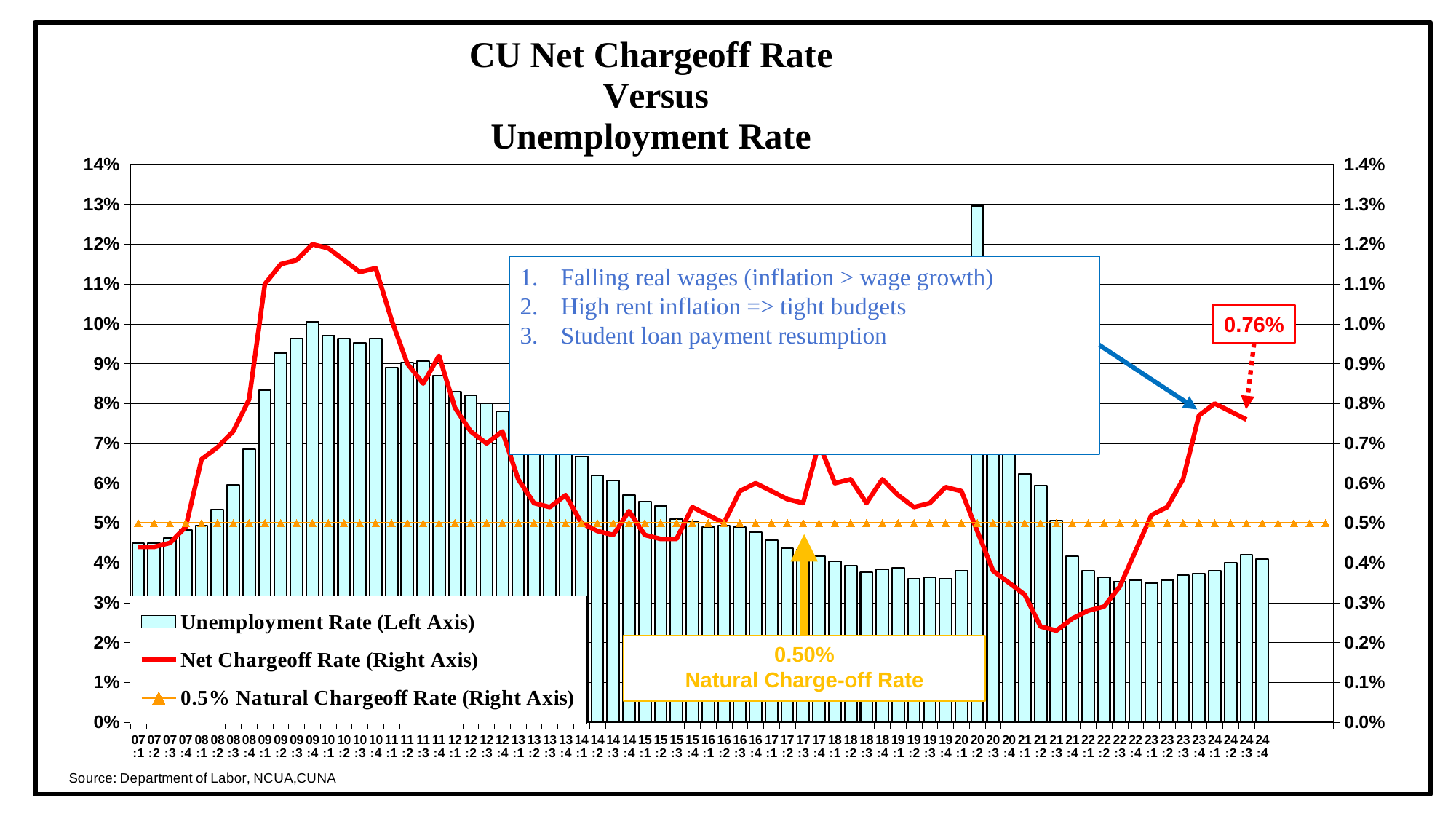
Does the Unemployment Rate rise or fall from 21:1 to 21:4? fall On which axis is the Unemployment Rate plotted? Left Axis What is the title of the chart? CU Net Chargeoff Rate Versus Unemployment Rate Is the Net Chargeoff Rate for 21:3 greater or less than 0.3%? less How many series does the legend list? 3 Which quarter has the highest Unemployment Rate? 20:2 What is the labeled value of the Net Chargeoff Rate at the end of the series? 0.76% What value does the Natural Chargeoff Rate line sit at? 0.50% Is the Unemployment Rate for 23:1 greater or less than 4%? less Is the Unemployment Rate for 20:2 greater or less than 12%? greater What kind of chart is shown on the slide? A combination bar and line chart